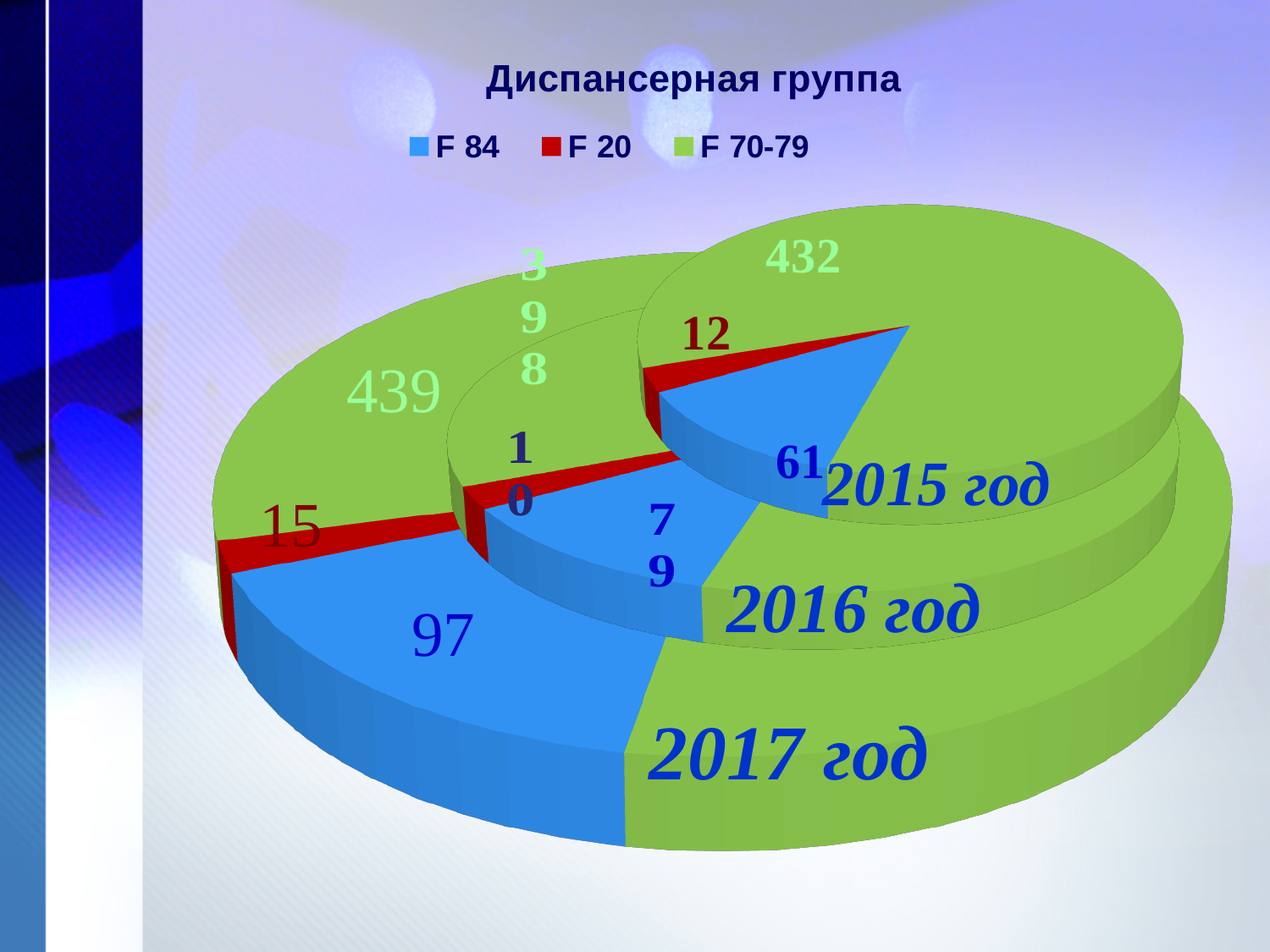
Which is larger: the F 70-79 value in the 2017 год pie or in the 2016 год pie? 2017 год What is the title of the chart on the slide? Диспансерная группа In the 2016 год pie, which category has the smallest slice? F 20 How many series does the legend list? 3 What is the difference between the F 84 value in the 2017 год pie and the F 84 value in the 2015 год pie? 36 In the 2017 год pie, which category has the largest slice? F 70-79 In the 2016 год pie, what is the value for F 20? 10 Which colour represents F 20 in the legend? red In the 2015 год pie, what is the value for F 84? 61 What kind of chart is shown on the slide? pie chart In the 2017 год pie, what is the value for F 84? 97 In the 2015 год pie, what is the value for F 70-79? 432